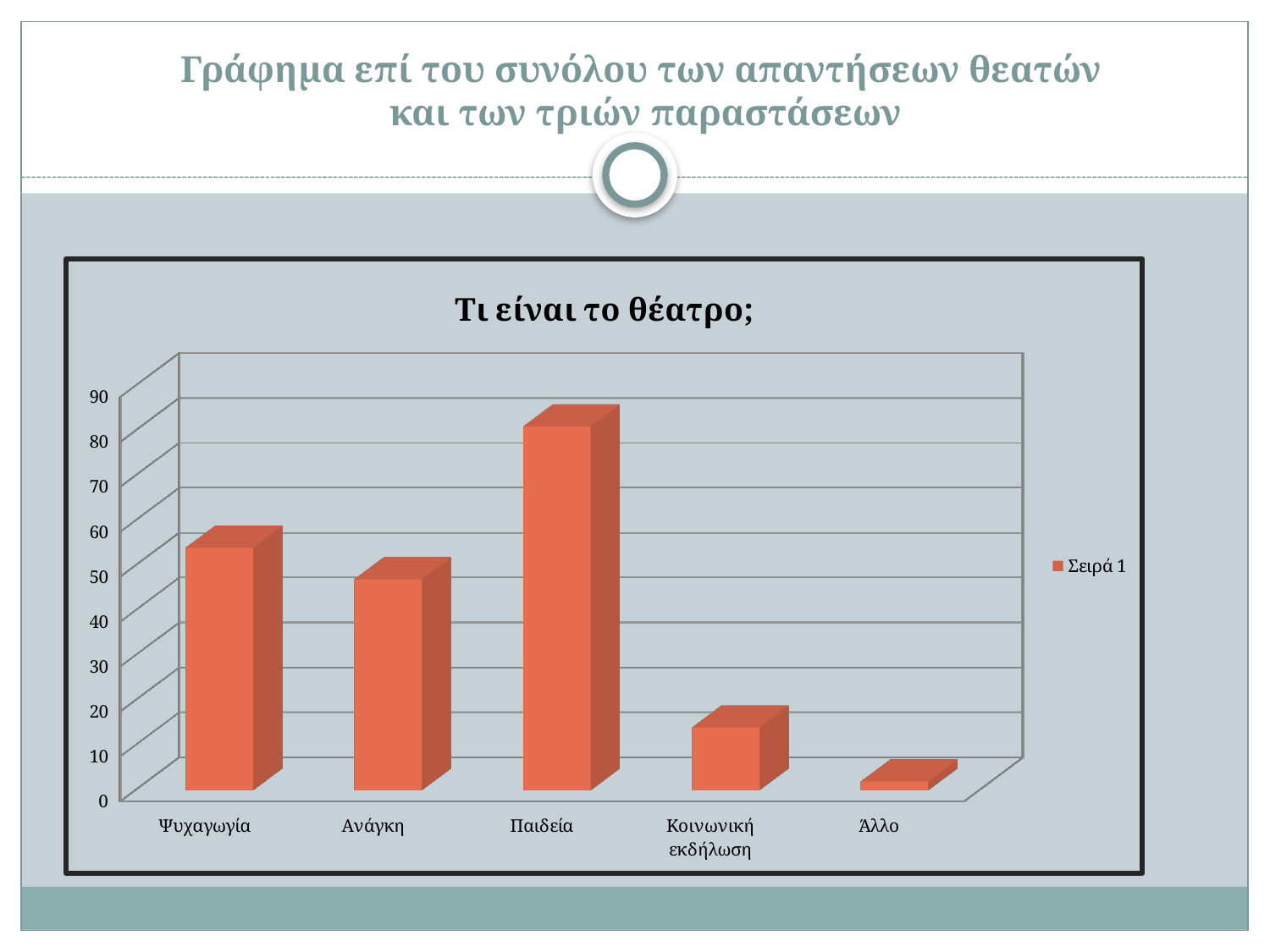
What is the title of the chart? Τι είναι το θέατρο; Is the value for Ψυχαγωγία greater or less than 40? greater Which category has the lowest value? Άλλο Which is larger, the value for Ψυχαγωγία or the value for Ανάγκη? Ψυχαγωγία How many series does the legend list? 1 Is the value for Παιδεία greater or less than 70? greater Is the value for Κοινωνική εκδήλωση greater or less than 20? less Which category has the highest value? Παιδεία How many categories are shown on the x axis of the chart? 5 What kind of chart is shown on the slide? bar chart Which is larger, the value for Κοινωνική εκδήλωση or the value for Παιδεία? Παιδεία What is the name of the series shown in the legend? Σειρά 1